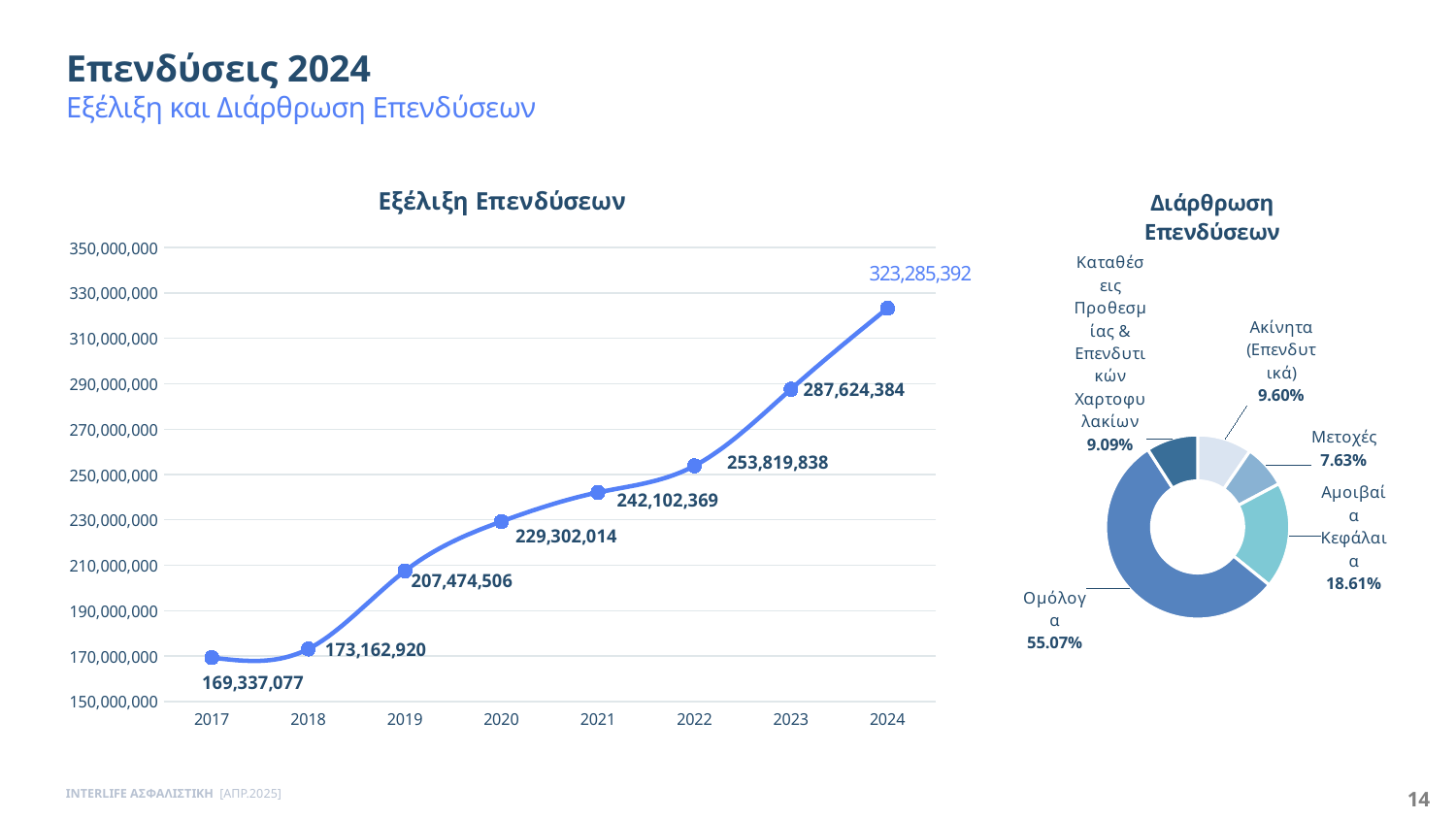
In the 'Εξέλιξη Επενδύσεων' chart, what is the difference between the 2024 and 2023 values? 35,661,008 In the 'Διάρθρωση Επενδύσεων' chart, what share do Ομόλογα have? 55.07% How many categories does the 'Διάρθρωση Επενδύσεων' chart show? 5 In the 'Εξέλιξη Επενδύσεων' chart, do the values rise or fall from 2017 to 2024? rise In the 'Διάρθρωση Επενδύσεων' chart, which is larger: Ακίνητα (Επενδυτικά) or Μετοχές? Ακίνητα (Επενδυτικά) What kind of chart is 'Εξέλιξη Επενδύσεων'? line chart In the 'Εξέλιξη Επενδύσεων' chart, what is the value for 2024? 323,285,392 In the 'Διάρθρωση Επενδύσεων' chart, which category has the smallest share? Μετοχές In the 'Εξέλιξη Επενδύσεων' chart, what is the value for 2019? 207,474,506 In the 'Εξέλιξη Επενδύσεων' chart, which year has the lowest value? 2017 In the 'Εξέλιξη Επενδύσεων' chart, how many years are plotted? 8 In the 'Διάρθρωση Επενδύσεων' chart, what is the percentage for Αμοιβαία Κεφάλαια? 18.61%